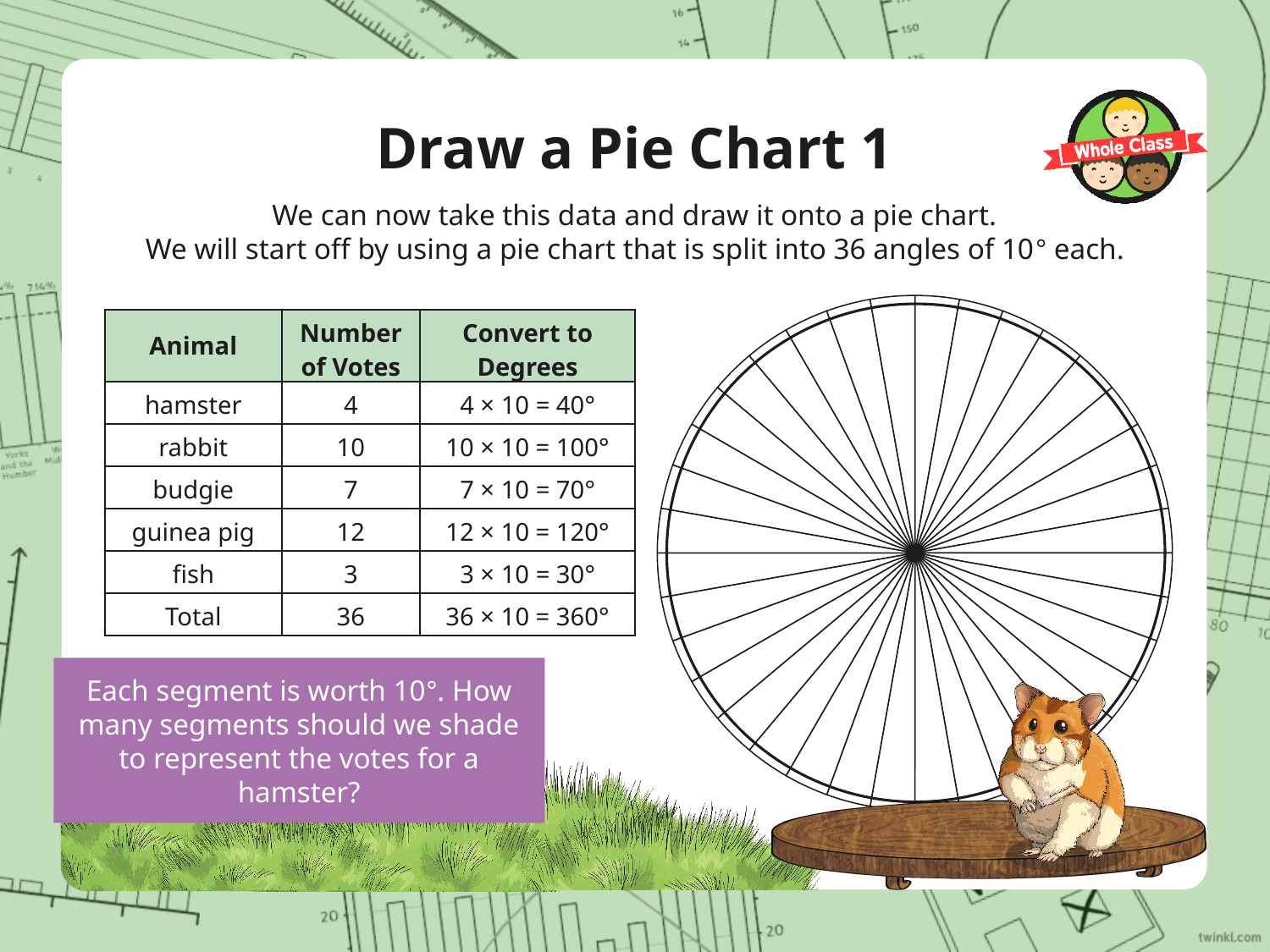
According to the table, how many more votes did rabbit get than budgie? 3 According to the table, how many degrees does guinea pig convert to? 120° According to the table, which got more votes, hamster or fish? hamster According to the table, which animal received the fewest votes? fish According to the table, which animal received the most votes? guinea pig What is the title of the slide? Draw a Pie Chart 1 How many equal segments is the pie chart on the slide split into? 36 What kind of chart is shown on the right of the slide? pie chart How many animals are listed in the table (excluding the total row)? 5 How many degrees is each segment of the pie chart worth? 10° According to the table, what is the total number of votes? 36 According to the table, how many votes did hamster receive? 4